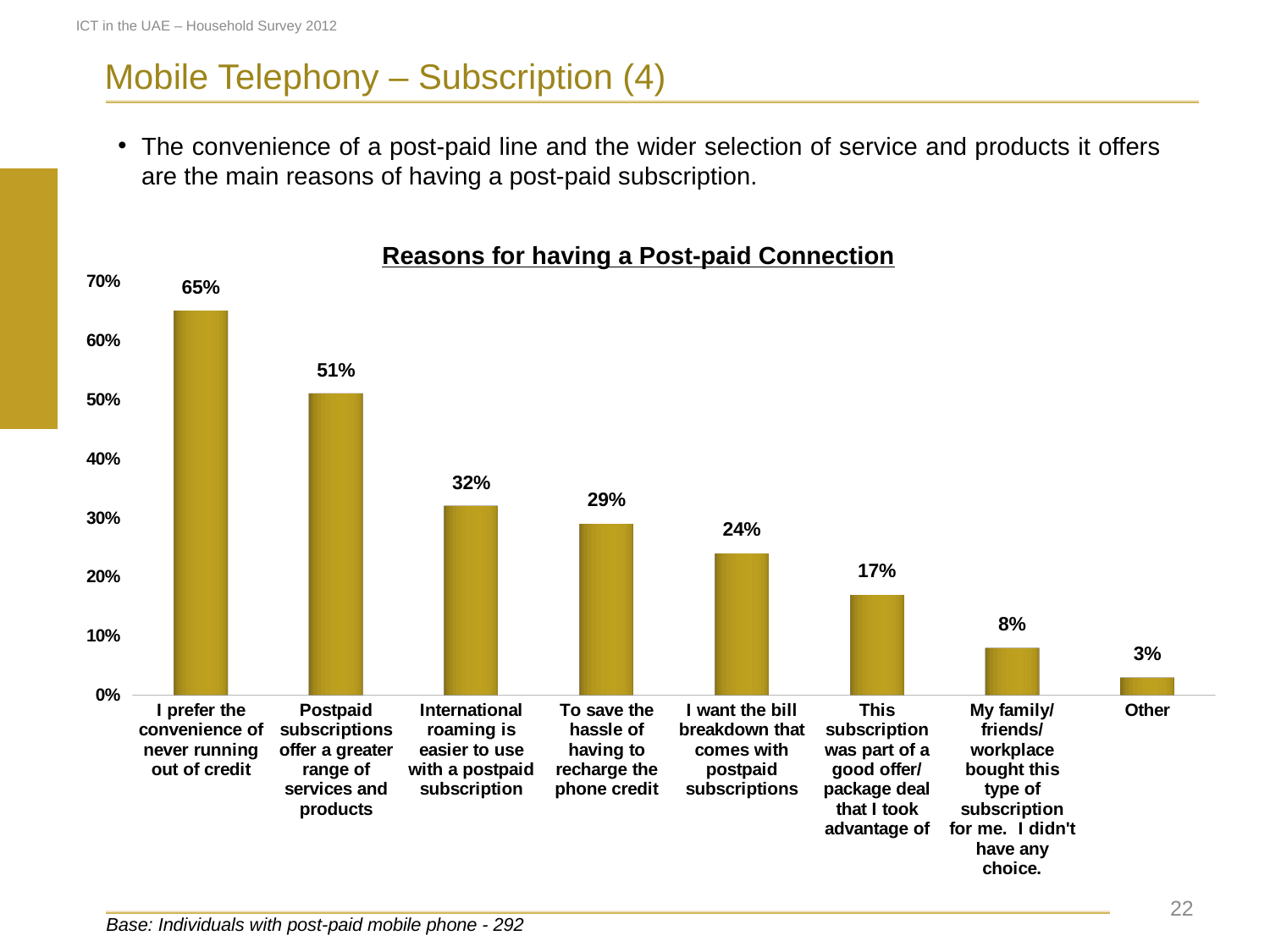
Which category has the lowest percentage in the chart? Other What kind of chart is shown on the slide? Bar chart What is the title of the chart? Reasons for having a Post-paid Connection How many categories (bars) are shown in the chart? 8 Which is larger: the value for "I want the bill breakdown that comes with postpaid subscriptions" or the value for "This subscription was part of a good offer/package deal that I took advantage of"? I want the bill breakdown that comes with postpaid subscriptions What is the value for "International roaming is easier to use with a postpaid subscription"? 32% Is the value for "My family/friends/workplace bought this type of subscription for me. I didn't have any choice." greater or less than 10%? less Which reason has the highest percentage in the chart? I prefer the convenience of never running out of credit What percentage is shown for "Other"? 3% What is the difference between the percentage for "Postpaid subscriptions offer a greater range of services and products" and "To save the hassle of having to recharge the phone credit"? 22% What percentage of respondents chose "I prefer the convenience of never running out of credit" as a reason for having a post-paid connection? 65% Do the values rise or fall moving from left to right along the x axis? Fall